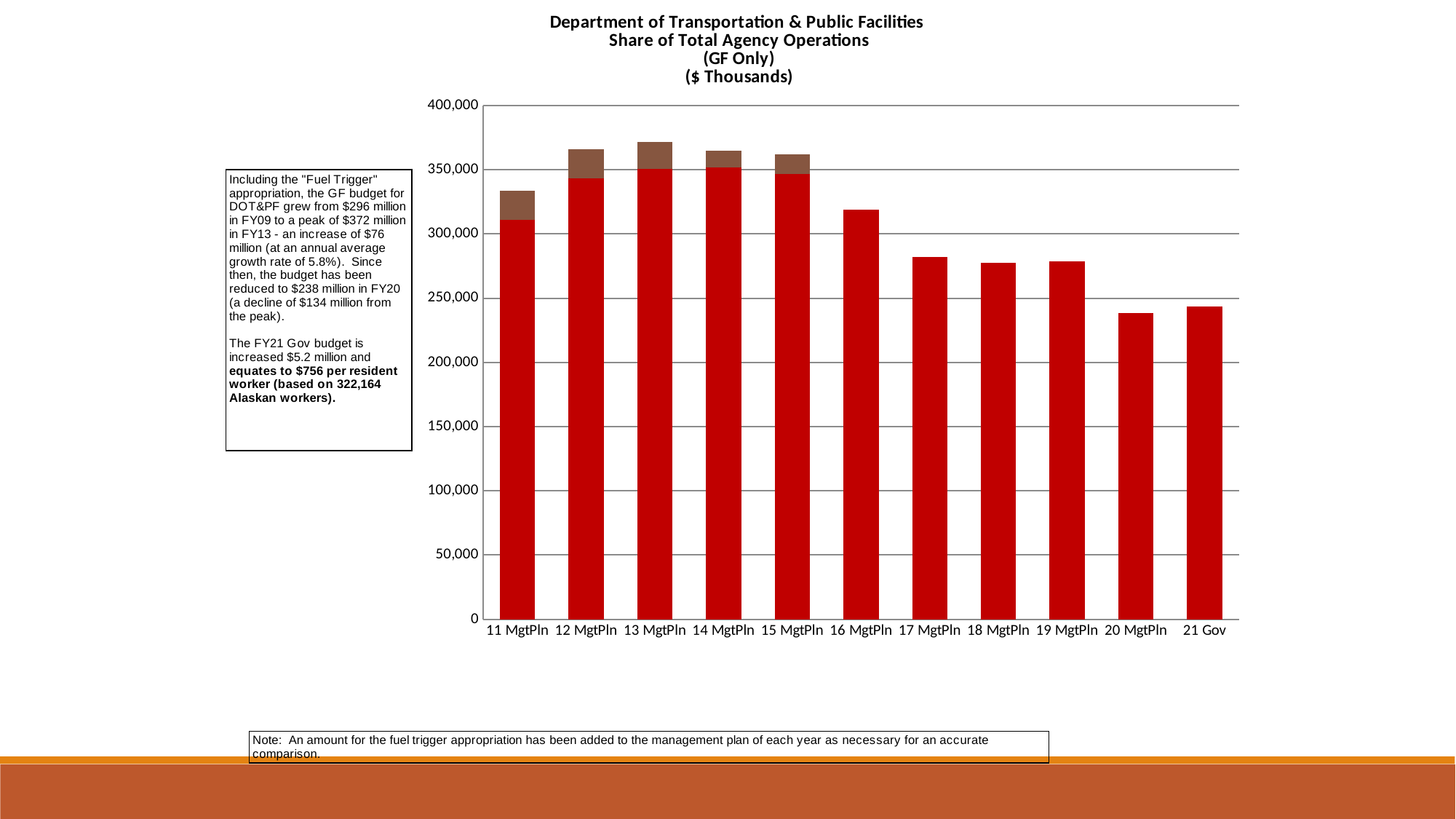
Is the value for 20 MgtPln greater or less than 250,000? less Which category has the lowest bar in the chart? 20 MgtPln How many categories are shown along the x axis of the chart? 11 Is the value for 16 MgtPln greater or less than 300,000? greater Which is larger, the bar for 16 MgtPln or the bar for 17 MgtPln? 16 MgtPln Do the bar values rise or fall from 16 MgtPln to 20 MgtPln? fall What kind of chart is shown on the slide? bar chart Is the value for 17 MgtPln greater or less than 300,000? less Which category has the highest total bar in the chart? 13 MgtPln Which is larger, the total bar for 12 MgtPln or the bar for 19 MgtPln? 12 MgtPln What is the highest value shown on the chart's y axis? 400,000